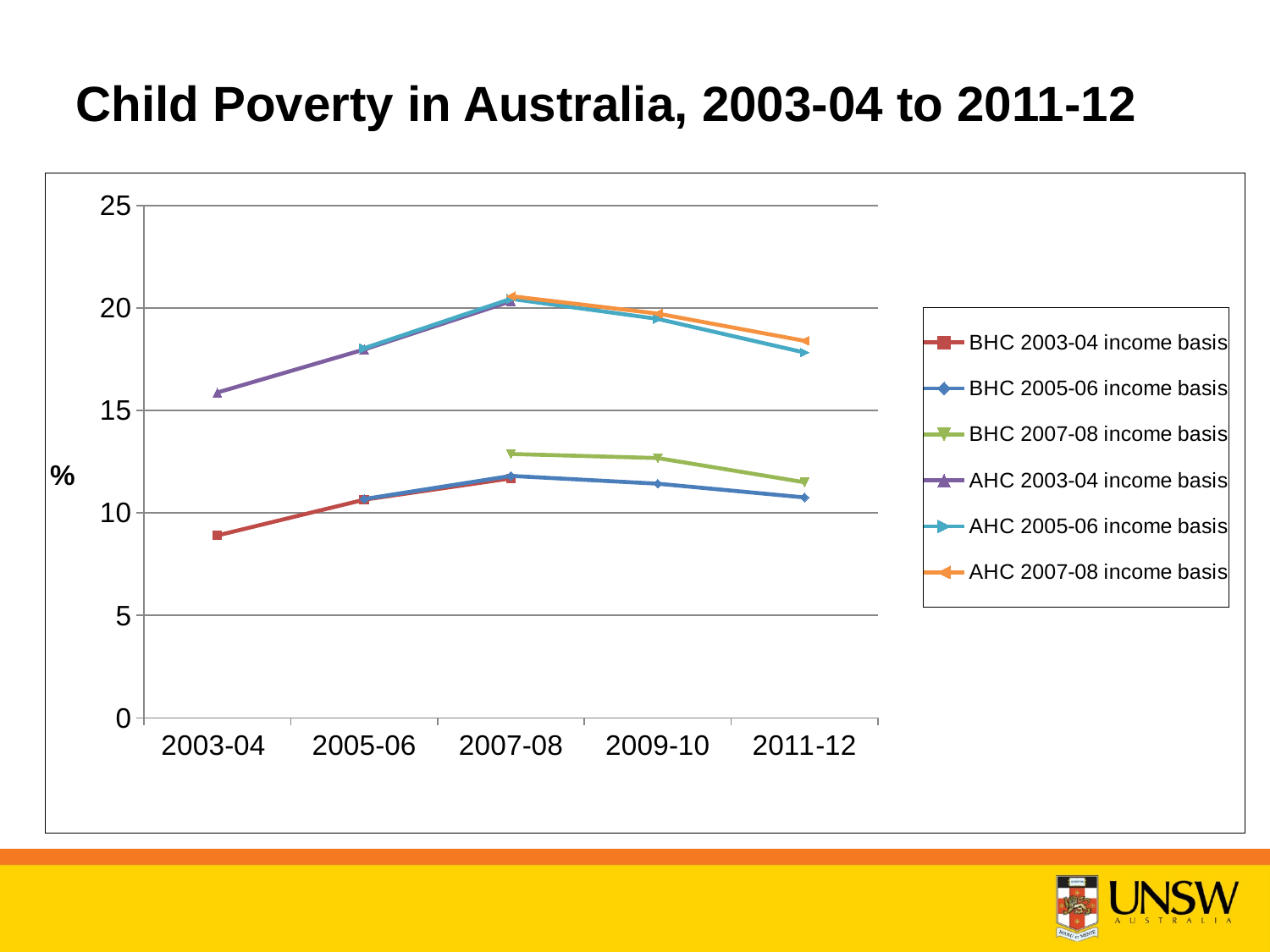
Does the BHC 2003-04 income basis series rise or fall from 2003-04 to 2007-08? rise Is the value for AHC 2007-08 income basis in 2011-12 greater or less than 20? less What is the title of the chart? Child Poverty in Australia, 2003-04 to 2011-12 Is the value for AHC 2005-06 income basis in 2011-12 greater or less than 15? greater Is the value for BHC 2007-08 income basis in 2007-08 greater or less than 10? greater Does the AHC 2005-06 income basis series rise or fall from 2007-08 to 2011-12? fall How many series does the legend list? 6 What kind of chart is shown on the slide? line chart How many time periods are shown on the x axis? 5 What label is shown on the vertical axis? % In 2011-12, which is larger: AHC 2007-08 income basis or BHC 2007-08 income basis? AHC 2007-08 income basis